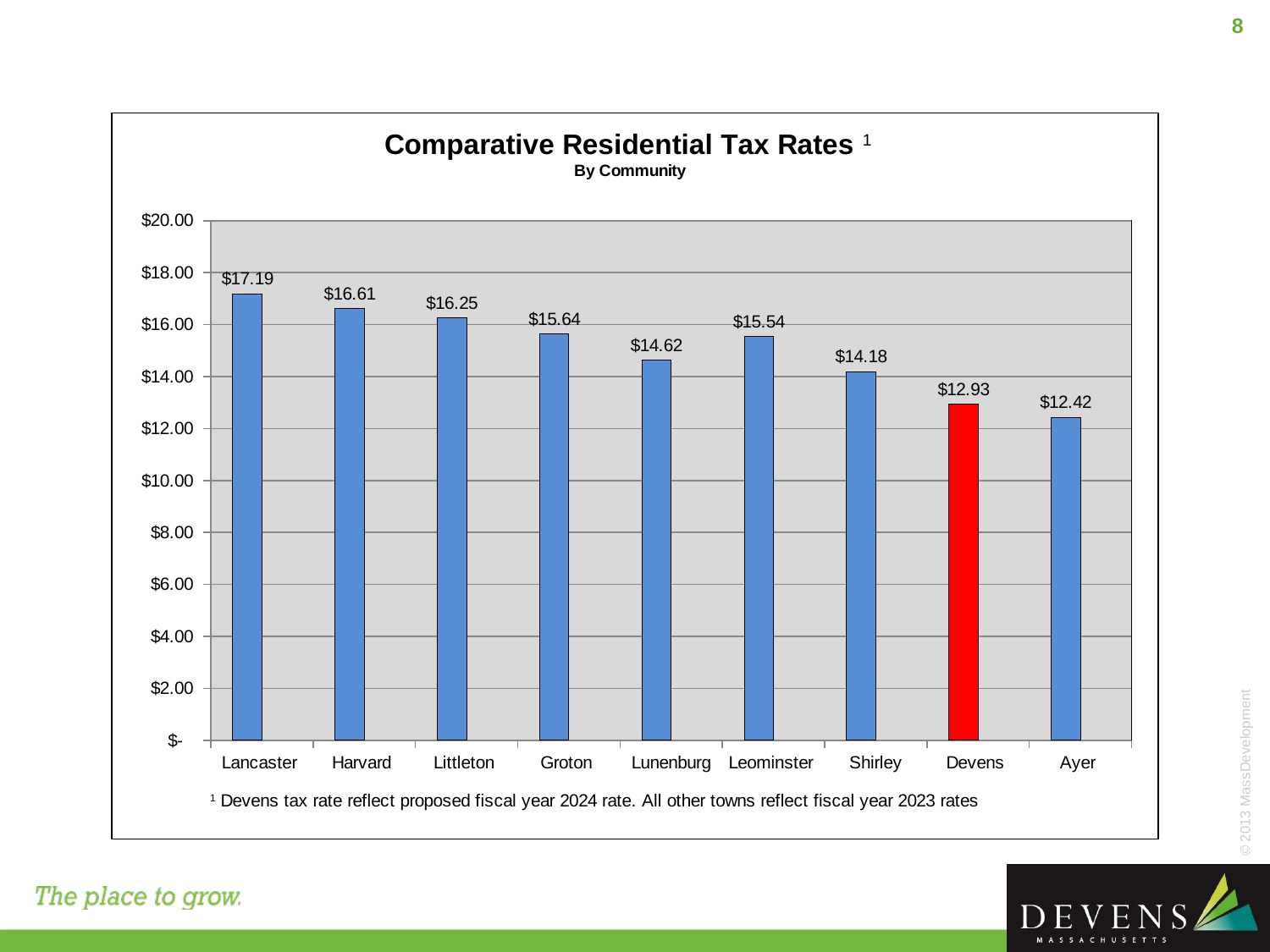
What is the residential tax rate for Shirley? $14.18 What kind of chart is shown on the slide? Bar chart Which has a higher residential tax rate, Lunenburg or Leominster? Leominster Which community has the lowest residential tax rate? Ayer What is the difference between the tax rates of Harvard and Littleton? $0.36 Which community's bar is coloured red? Devens What is the residential tax rate for Groton? $15.64 How many communities are shown in the chart? 9 Is the value for Ayer greater or less than $14.00? less What is the residential tax rate for Devens? $12.93 What is the difference between the tax rates of Lancaster and Devens? $4.26 Which community has the highest residential tax rate? Lancaster